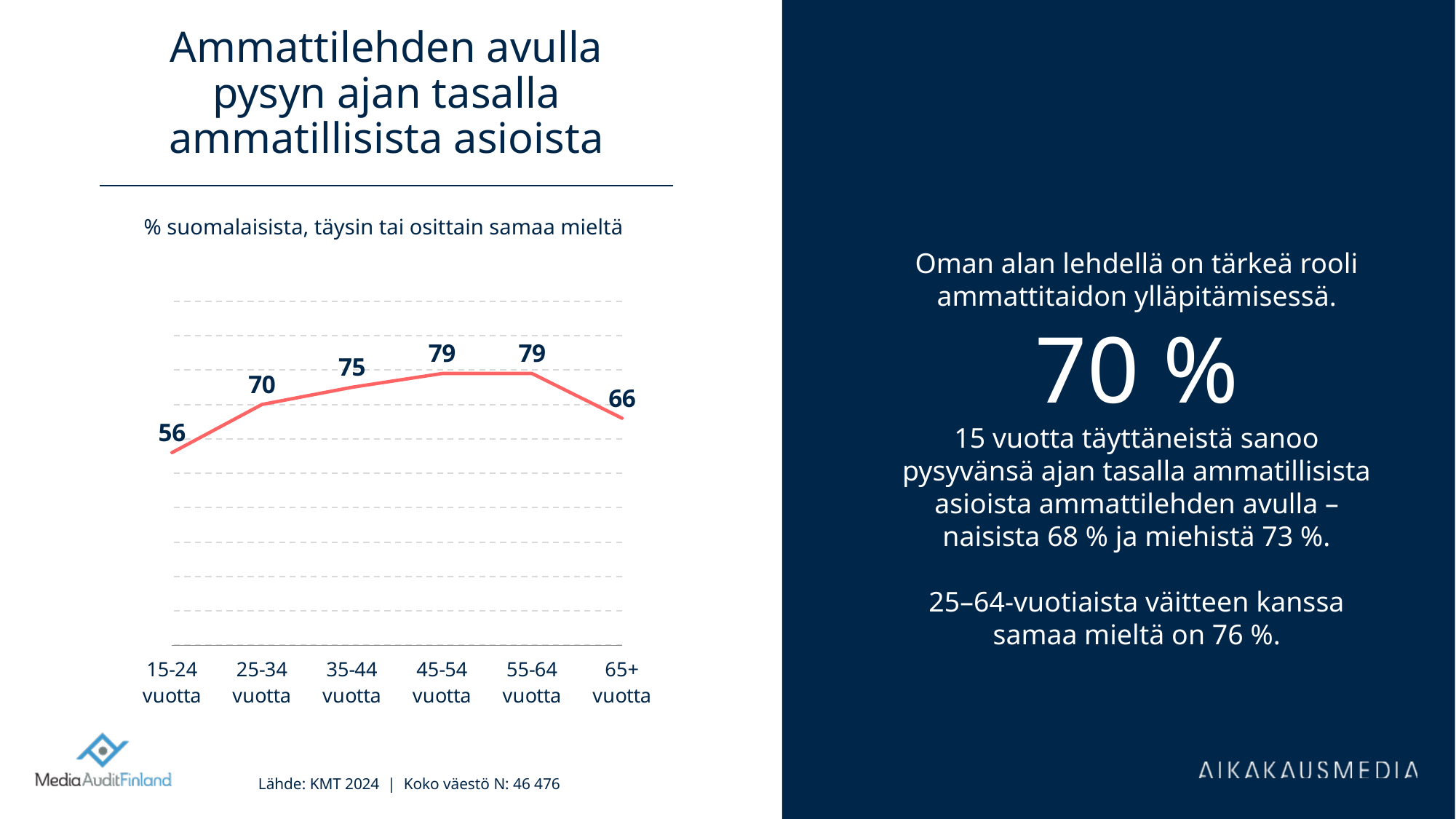
Which is larger, the value for 35-44 vuotta or the value for 65+ vuotta? 35-44 vuotta Do the values rise or fall from 15-24 vuotta to 45-54 vuotta? rise What is the value for the 25-34 vuotta age group? 70 Which age group has the lowest value? 15-24 vuotta What is the value for the 15-24 vuotta age group? 56 What is the difference between the values for 45-54 vuotta and 15-24 vuotta? 23 How many age groups are plotted on the chart? 6 What type of chart is shown on the slide? line chart What is the subtitle shown above the chart? % suomalaisista, täysin tai osittain samaa mieltä What is the value for the 35-44 vuotta age group? 75 What is the value for the 65+ vuotta age group? 66 What is the difference between the values for 55-64 vuotta and 65+ vuotta? 13